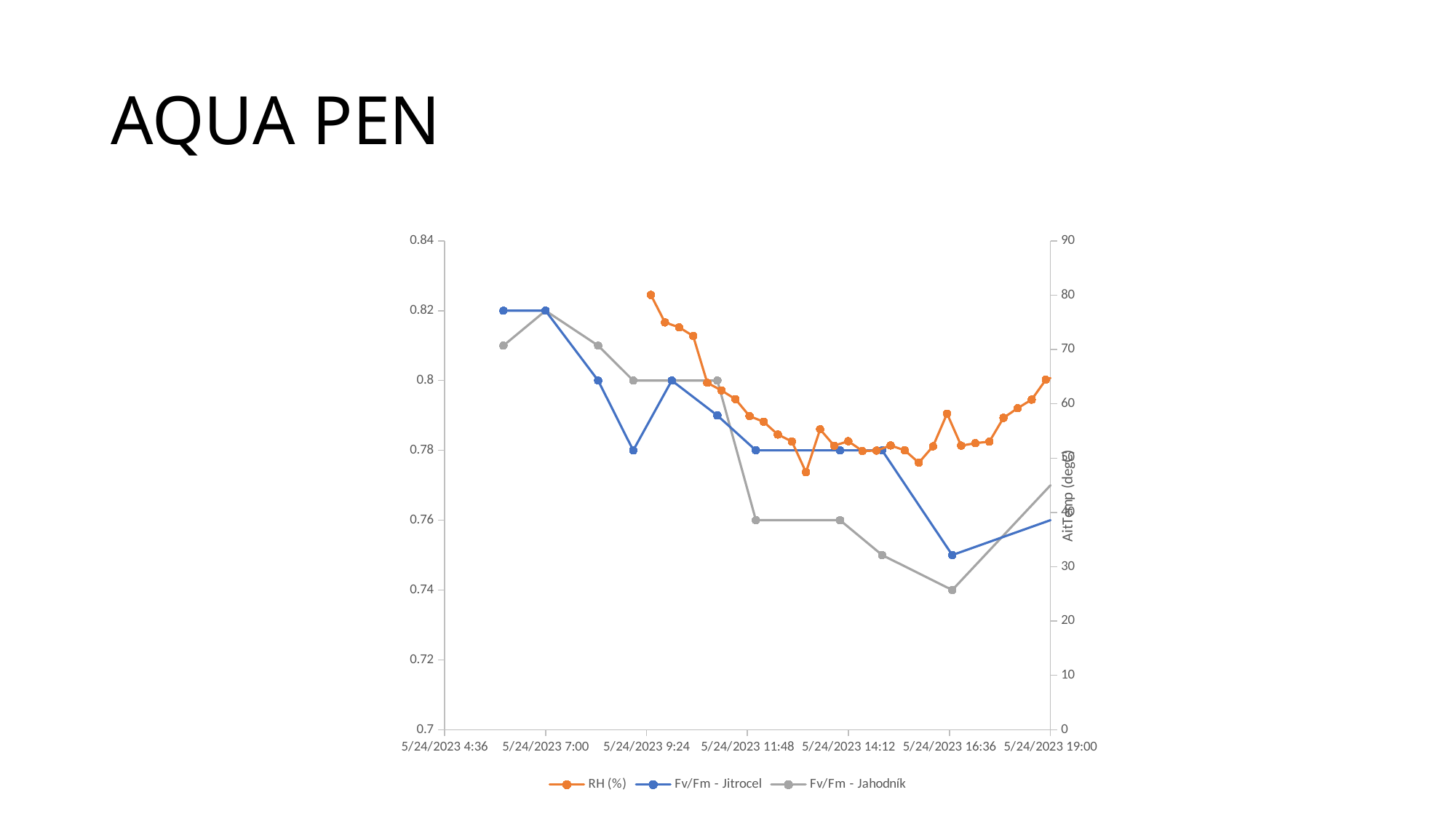
What is the value of Fv/Fm - Jitrocel at 5/24/2023 11:48? 0.78 Is the first RH (%) value (around 5/24/2023 9:24) greater or less than 70 on the right axis? greater How many series does the legend list? 3 What is the value of Fv/Fm - Jitrocel at 5/24/2023 7:00? 0.82 Which series is higher at 5/24/2023 11:48, Fv/Fm - Jitrocel or Fv/Fm - Jahodník? Fv/Fm - Jitrocel What is the value of Fv/Fm - Jahodník at 5/24/2023 7:00? 0.82 What is the difference between Fv/Fm - Jitrocel and Fv/Fm - Jahodník at 5/24/2023 11:48? 0.02 Which series is drawn in orange? RH (%) What is the value of Fv/Fm - Jahodník at 5/24/2023 11:48? 0.76 What is the lowest value reached by Fv/Fm - Jahodník? 0.74 What kind of chart is shown on the slide? line chart Does Fv/Fm - Jahodník rise or fall between 5/24/2023 7:00 and 5/24/2023 16:36? fall